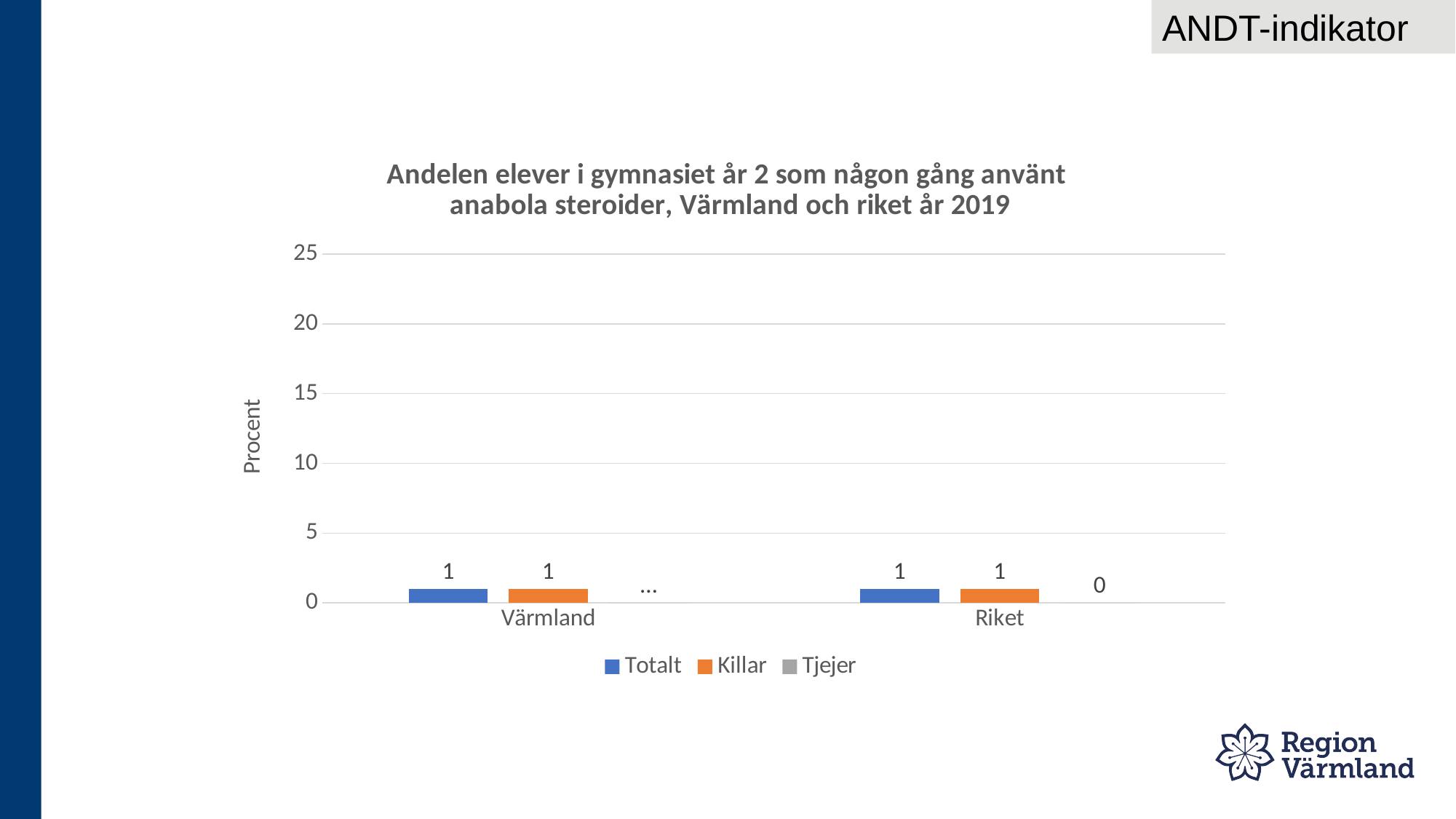
Which is larger in Riket, the value for Killar or the value for Tjejer? Killar What kind of chart is shown on the slide? Bar chart What is the value for Killar in Värmland? 1 What is the difference between the Totalt value for Värmland and the Totalt value for Riket? 0 Is the value for Totalt in Riket greater or less than 5? less What label is shown on the y axis? Procent How many series does the legend list? 3 What is the value for Killar in Riket? 1 What is the value for Totalt in Värmland? 1 What is the value for Tjejer in Riket? 0 How many categories are shown on the x axis? 2 Which series is shown in orange in the legend? Killar